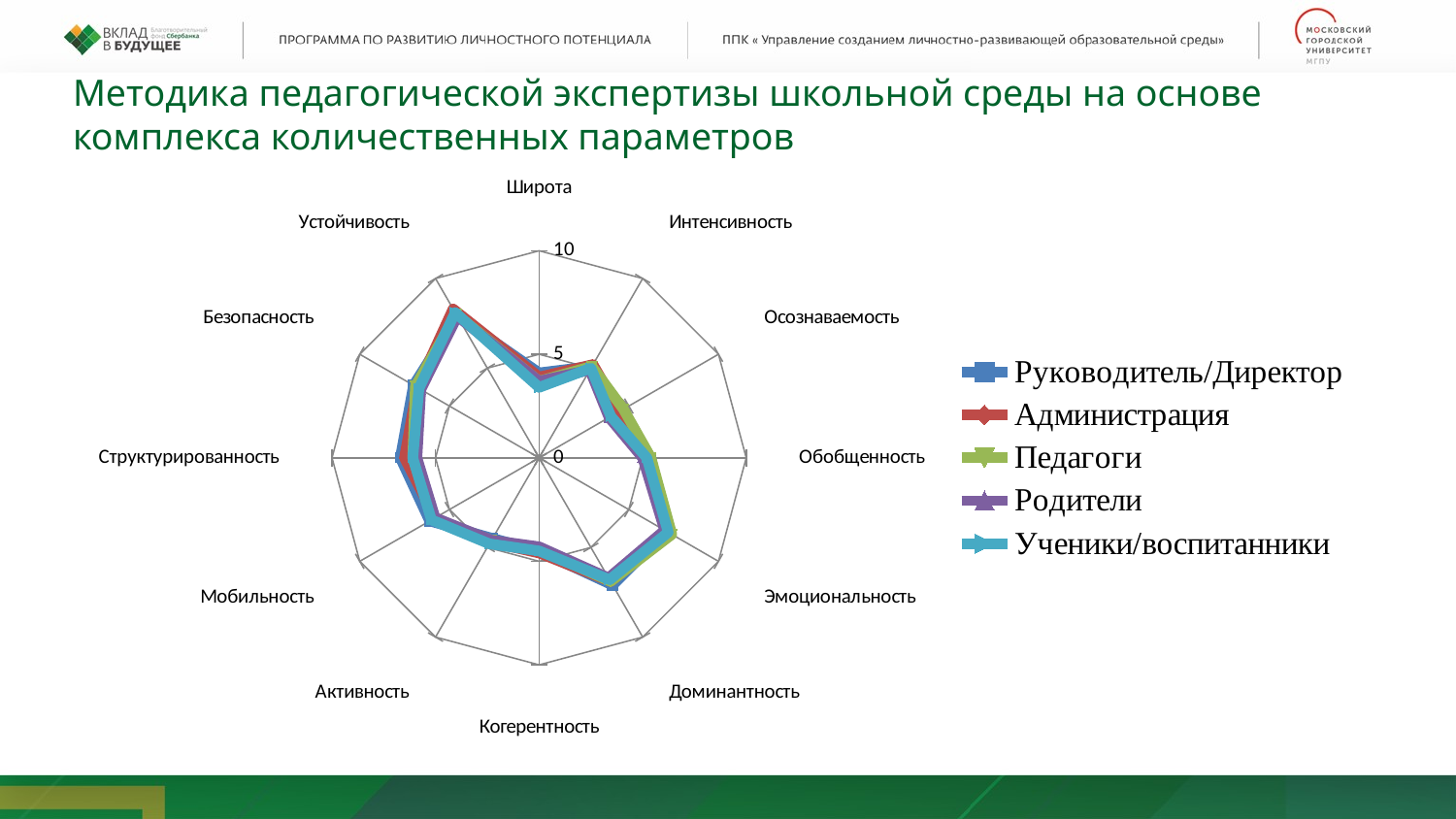
Is the value for Широта greater or less than 5? less What is the maximum value shown on the radar chart's axis scale? 10 Which category has the highest values on the radar chart? Устойчивость How many categories (axes) does the radar chart have? 12 Which series is listed first in the legend? Руководитель/Директор Which is larger, the value for Устойчивость or the value for Широта? Устойчивость Is the value for Безопасность greater or less than 5? greater What kind of chart is shown on the slide? radar chart Is the value for Устойчивость greater or less than 5? greater How many series does the legend list? 5